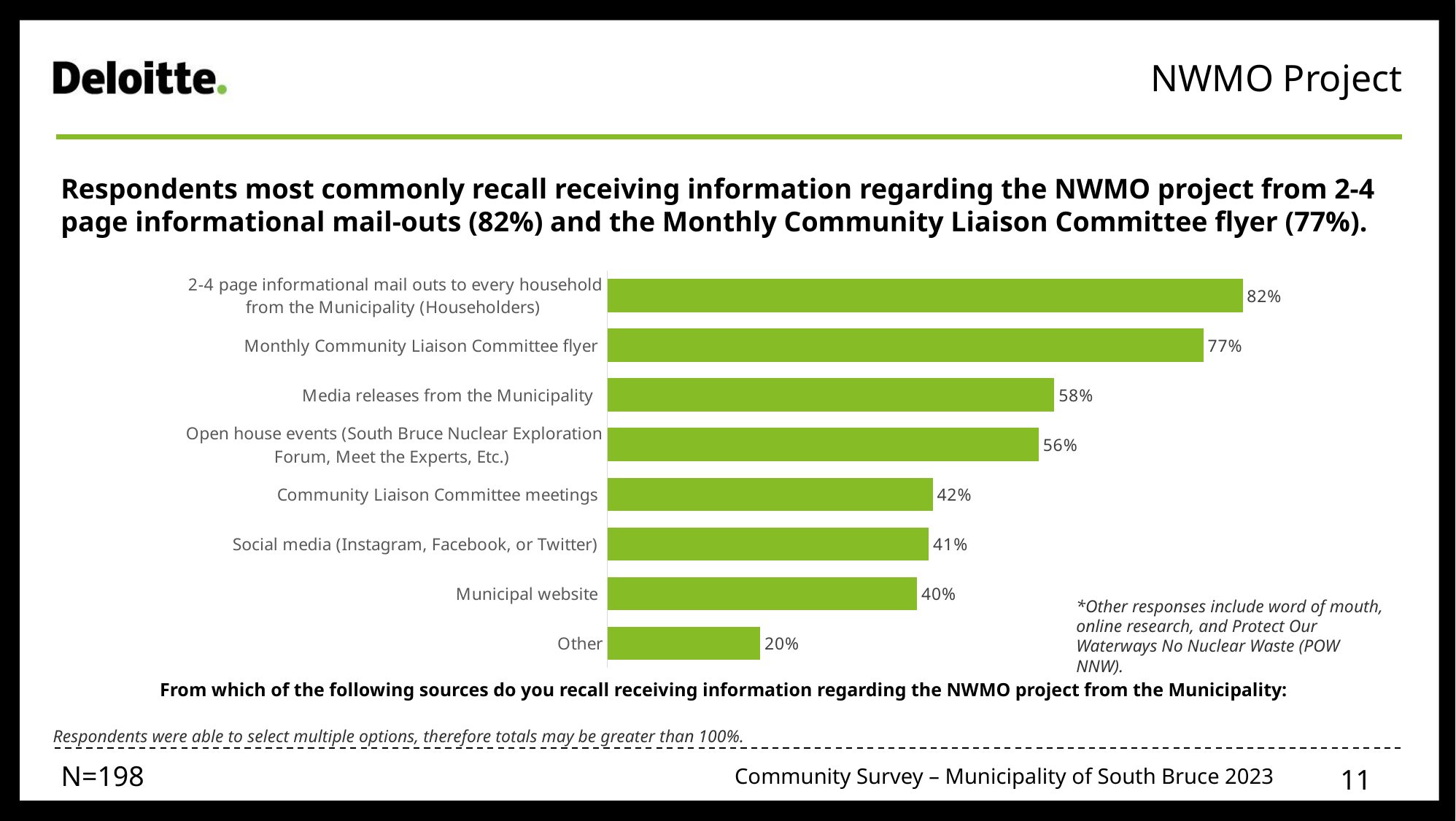
What is the difference between the values for 2-4 page informational mail outs and Open house events? 26% What is the difference between Community Liaison Committee meetings and Other? 22% What is the sample size (N) shown on the slide? N=198 Which source has the highest percentage of respondents? 2-4 page informational mail outs to every household from the Municipality (Householders) What percentage of respondents selected Social media (Instagram, Facebook, or Twitter)? 41% How many categories are shown in the chart? 8 Which is larger: Media releases from the Municipality or Open house events? Media releases from the Municipality What is the value for the Municipal website? 40% Which category has the lowest value in the chart? Other What percentage of respondents recall receiving information from the Monthly Community Liaison Committee flyer? 77% What is the value for Media releases from the Municipality? 58% What kind of chart is shown on the slide? Bar chart